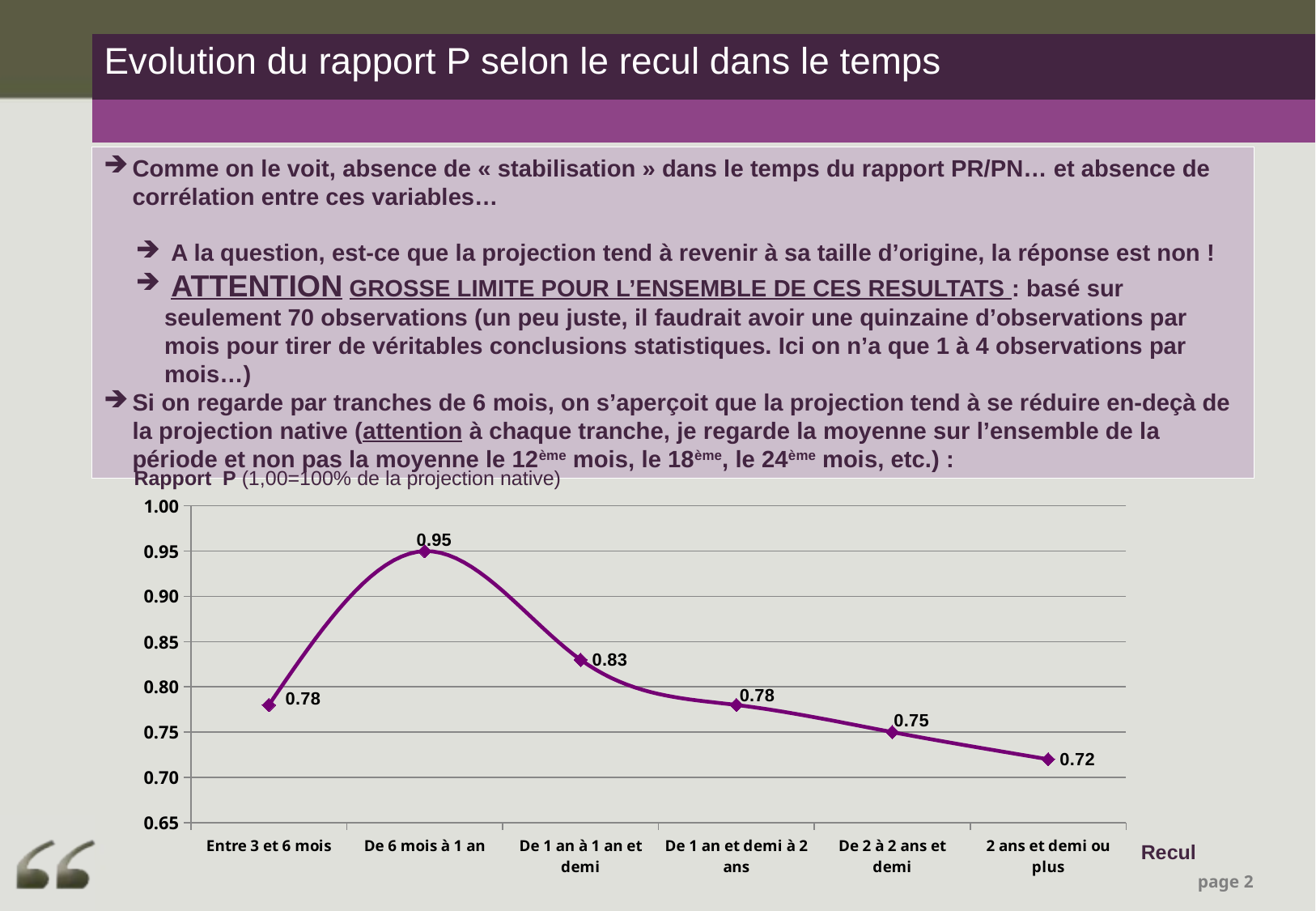
What is the Rapport P value for 'Entre 3 et 6 mois'? 0.78 How many recul categories are plotted on the chart? 6 Which has a larger Rapport P value: 'De 1 an à 1 an et demi' or 'De 2 à 2 ans et demi'? De 1 an à 1 an et demi What is the difference between the Rapport P values for 'De 6 mois à 1 an' and 'De 1 an à 1 an et demi'? 0.12 Which recul category has the highest Rapport P value? De 6 mois à 1 an What is the label of the x axis of the chart? Recul What type of chart is shown on the slide? line chart What is the Rapport P value for 'De 6 mois à 1 an'? 0.95 Is the Rapport P value for 'De 6 mois à 1 an' greater or less than 0.90? greater What is the Rapport P value for '2 ans et demi ou plus'? 0.72 From 'De 6 mois à 1 an' onwards, do the Rapport P values rise or fall along the x axis? fall Which recul category has the lowest Rapport P value? 2 ans et demi ou plus